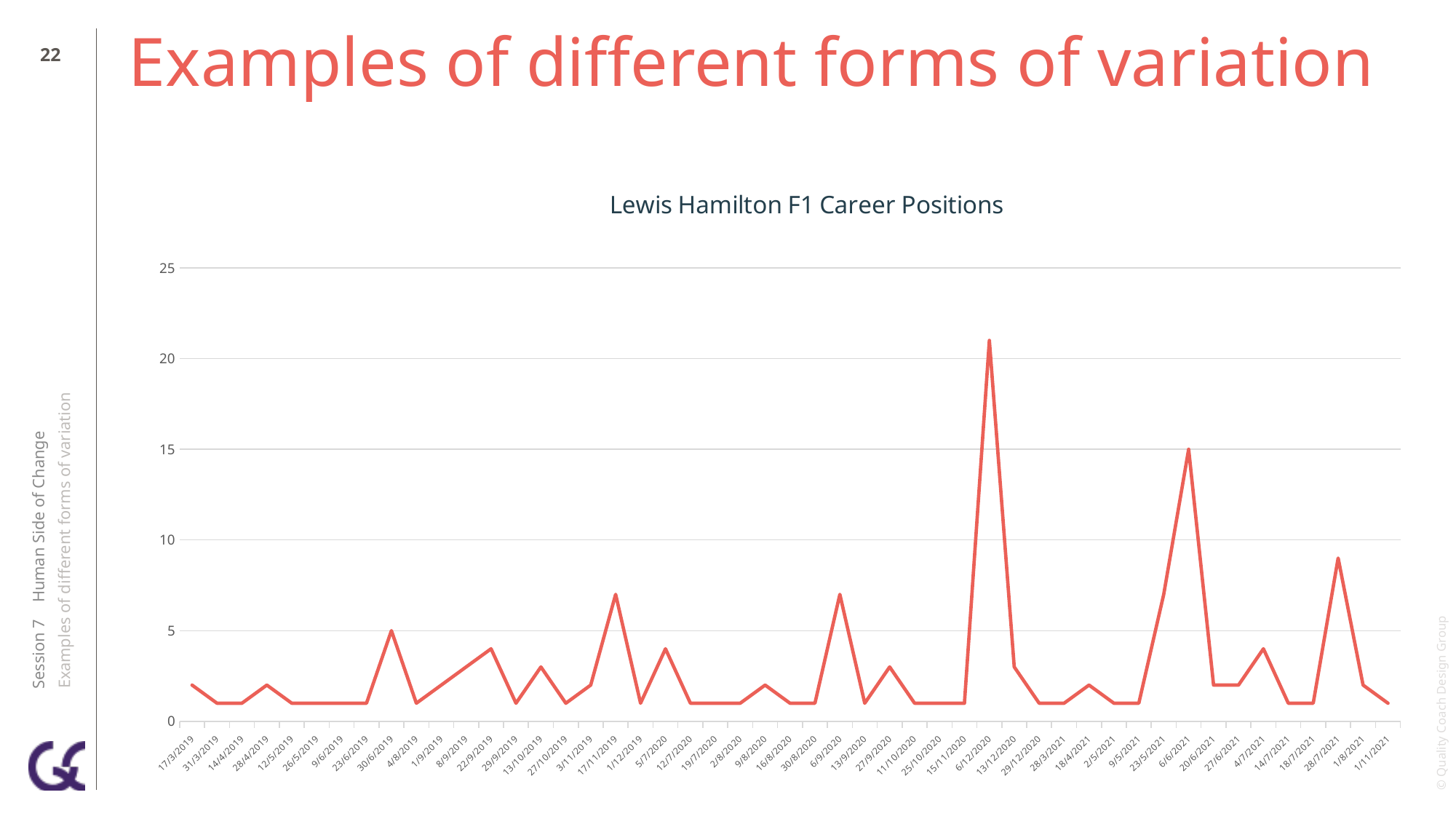
What colour is the plotted line? red Which has the larger value, 6/6/2021 or 28/7/2021? 6/6/2021 On which date does the line reach its highest value? 6/12/2020 Is the value for 31/3/2019 greater or less than 5? less What kind of chart is shown on the slide? line chart What is the value for 30/6/2019? 5 Is the value for 17/11/2019 greater or less than 5? greater What is the value for 6/6/2021? 15 What is the title of the chart? Lewis Hamilton F1 Career Positions Which has the larger value, 6/12/2020 or 6/6/2021? 6/12/2020 Is the value for 6/12/2020 greater or less than 20? greater